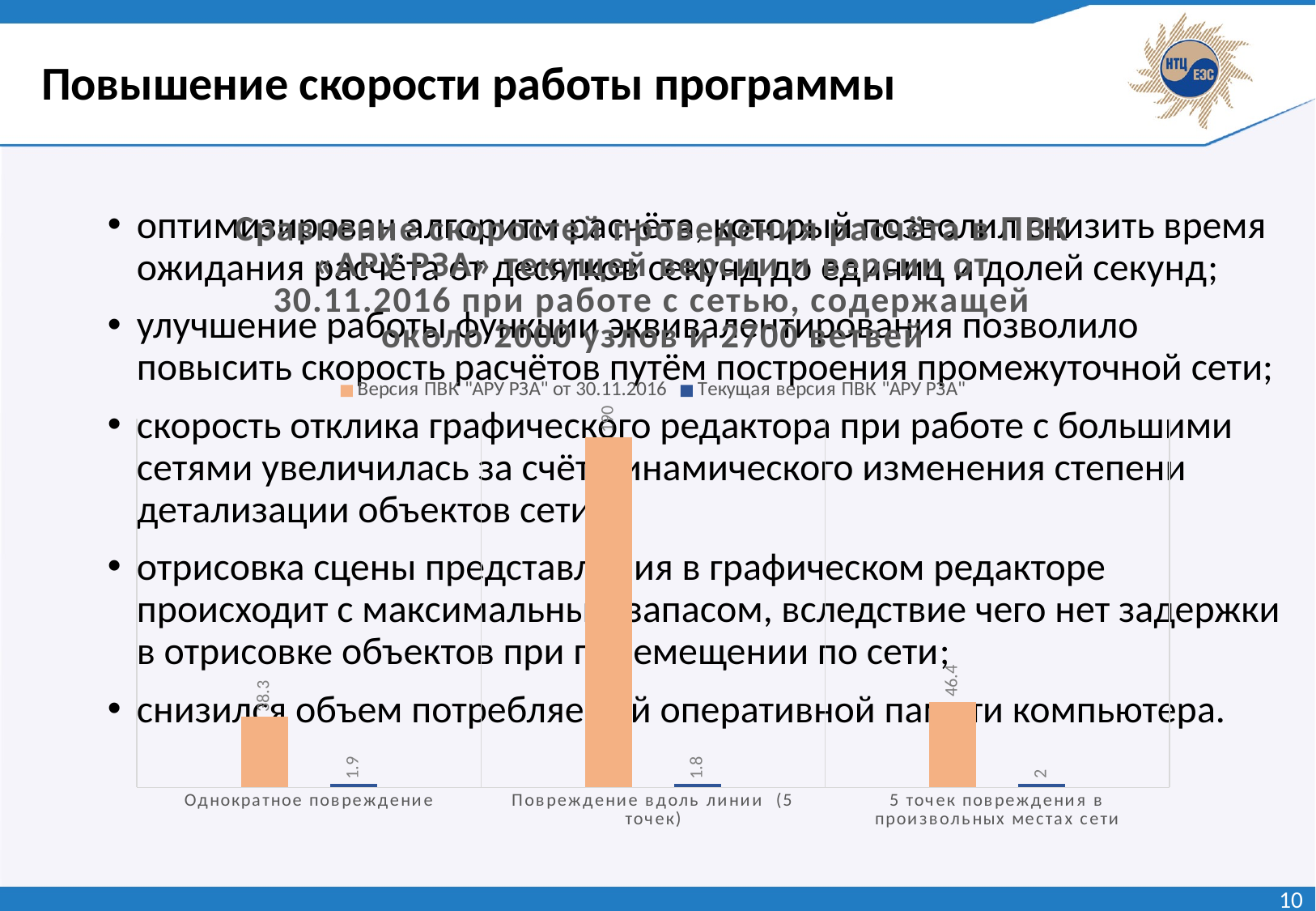
How many series does the chart legend list? 2 What is the value for "Однократное повреждение" for the series "Версия ПВК "АРУ РЗА" от 30.11.2016"? 38.3 Which category has the highest bar for the series "Версия ПВК "АРУ РЗА" от 30.11.2016"? Повреждение вдоль линии (5 точек) What is the value for "Повреждение вдоль линии (5 точек)" for the series "Текущая версия ПВК "АРУ РЗА""? 1.8 What is the value for "5 точек повреждения в произвольных местах сети" for the series "Текущая версия ПВК "АРУ РЗА""? 2 What is the value for "Однократное повреждение" for the series "Текущая версия ПВК "АРУ РЗА""? 1.9 What kind of chart is shown on the slide? bar chart What is the difference between the two series' values for "5 точек повреждения в произвольных местах сети"? 44.4 What is the value for "5 точек повреждения в произвольных местах сети" for the series "Версия ПВК "АРУ РЗА" от 30.11.2016"? 46.4 How many categories are shown along the x axis of the chart? 3 For "5 точек повреждения в произвольных местах сети", which series has the larger value: "Версия ПВК "АРУ РЗА" от 30.11.2016" or "Текущая версия ПВК "АРУ РЗА""? Версия ПВК "АРУ РЗА" от 30.11.2016 What colour represents the series "Версия ПВК "АРУ РЗА" от 30.11.2016" in the chart? orange